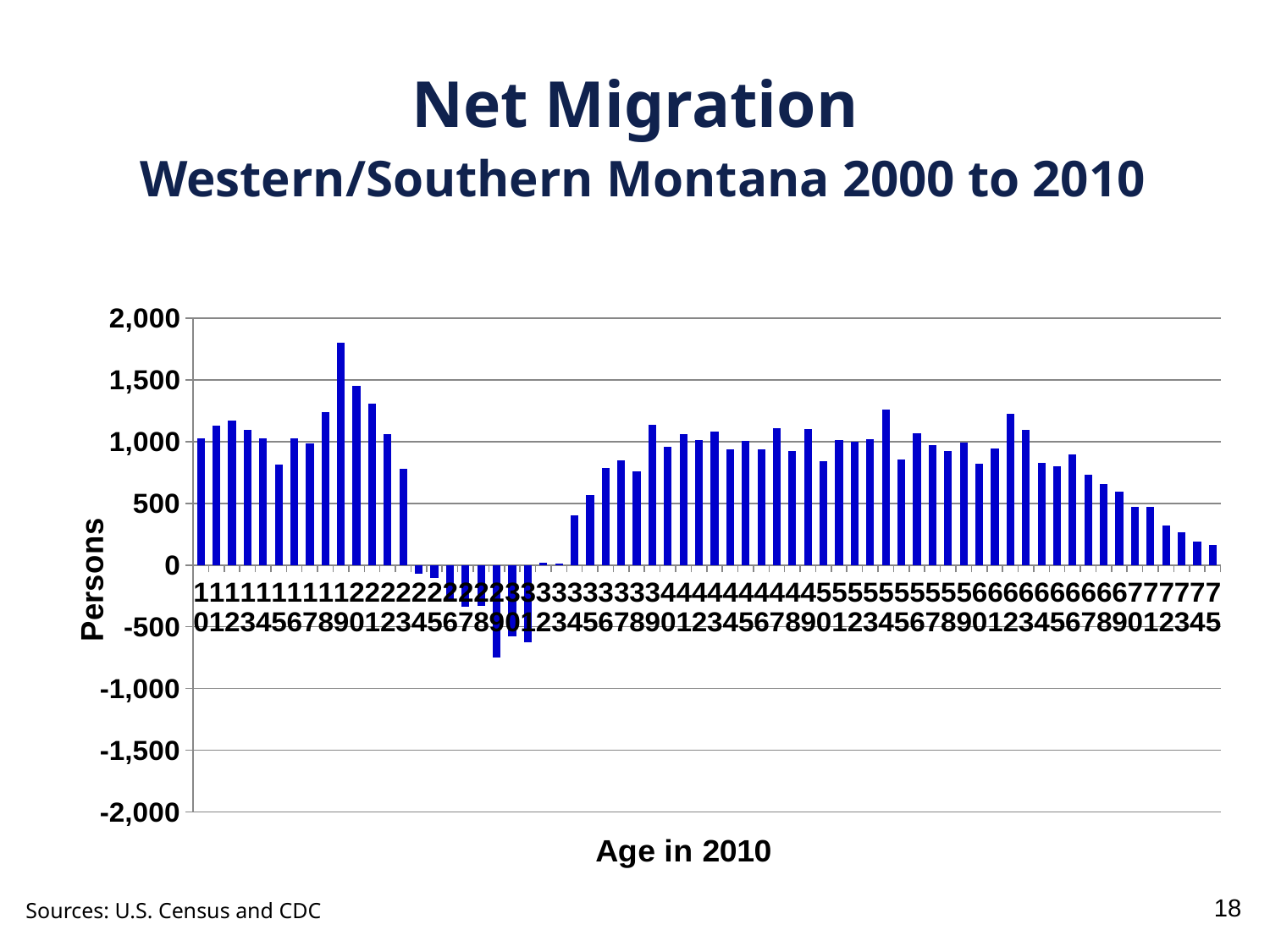
Is the value for age 20 greater or less than 1,500? less What kind of chart is shown on the slide? bar chart Is the value for age 75 greater or less than 500? less Is the value for age 55 greater or less than 1,000? less Which age has the lowest net migration? 29 What is the title of the chart on the slide? Net Migration Western/Southern Montana 2000 to 2010 How many age categories are plotted on the x axis? 66 What is the label of the vertical axis? Persons Which age has the highest net migration? 19 Which is larger, the value for age 20 or the value for age 21? age 20 Do the values rise or fall from age 66 to age 75? fall